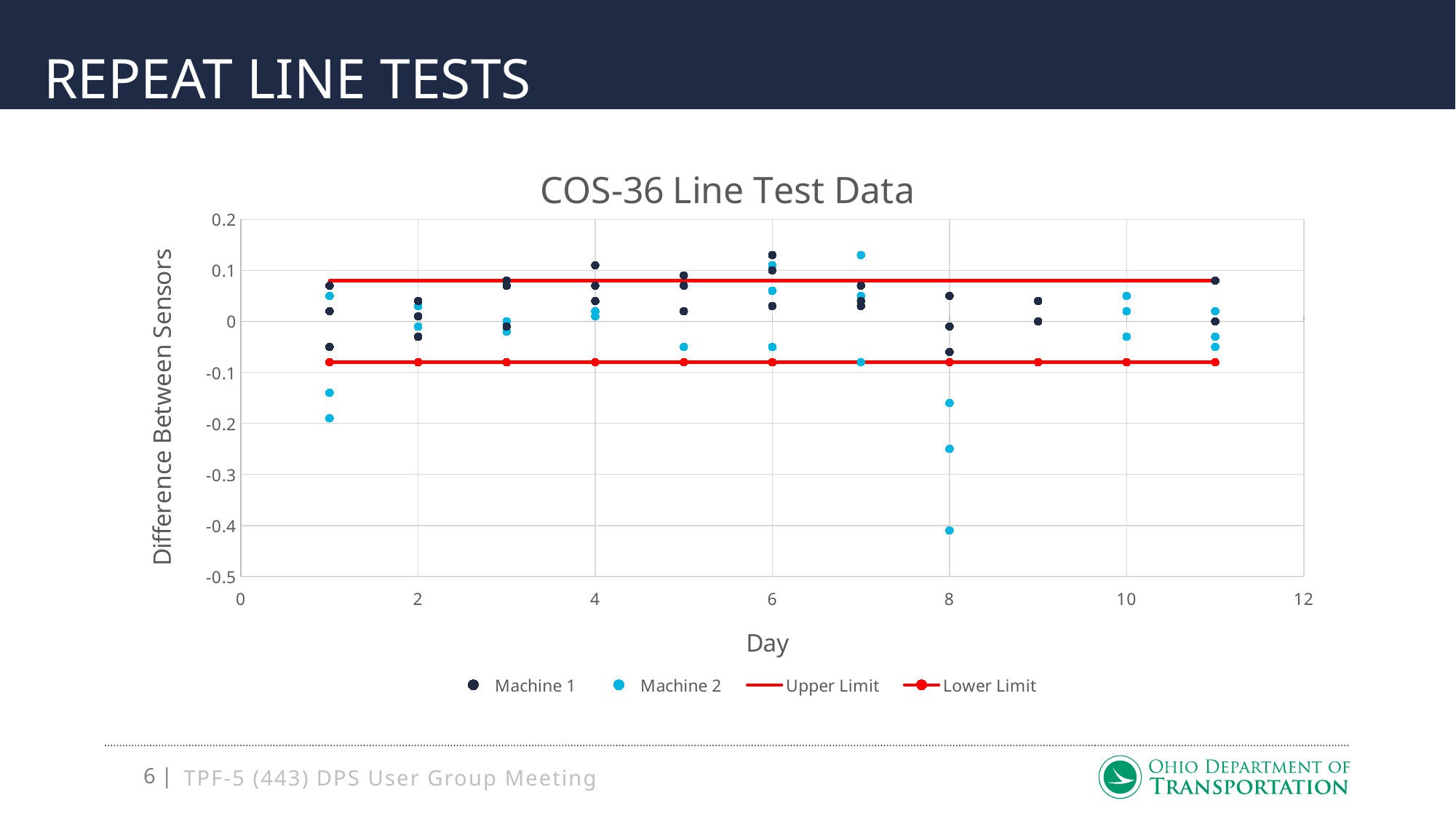
Does the Upper Limit line rise, fall, or stay flat across the days? Stays flat Is the Lower Limit line greater or less than -0.1? greater On which day does Machine 2 have its lowest value? 8 Which is lower: the lowest Machine 2 value on day 1 or the lowest Machine 2 value on day 8? Day 8 What is the label of the vertical axis? Difference Between Sensors Are the Machine 2 values on day 1 that fall below the Lower Limit greater or less than -0.1? less Is the lowest Machine 2 value on day 8 greater or less than -0.3? less How many days have data points plotted on the chart? 11 What is the title of the chart? COS-36 Line Test Data How many series does the chart legend list? 4 What kind of chart is shown on the slide? Scatter chart